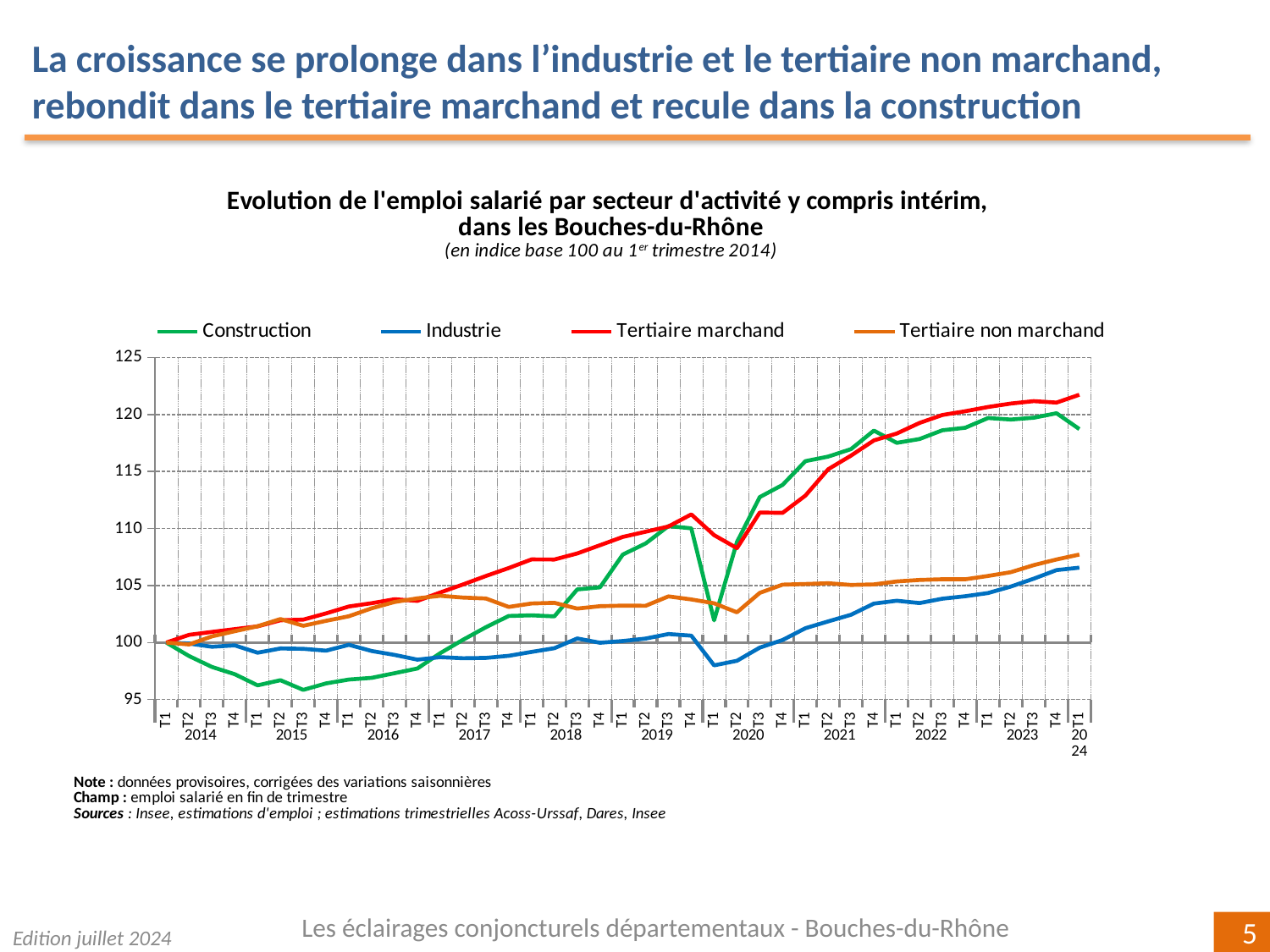
Does the Tertiaire marchand series generally rise or fall from 2014 to 2024? rise Is the value for Tertiaire marchand at T1 2024 greater or less than 120? greater Is the value for Construction at T3 2015 greater or less than 100? less How many series does the legend list? 4 Is the value for Tertiaire non marchand at T1 2024 greater or less than 105? greater What kind of chart is shown on the slide? line chart What is the value of the Construction series at T1 2014? 100 At T1 2024, which is higher: Construction or Industrie? Construction Which series is drawn in green in the legend? Construction Which series has the lowest value at T1 2024? Industrie Which series has the highest value at T1 2024? Tertiaire marchand